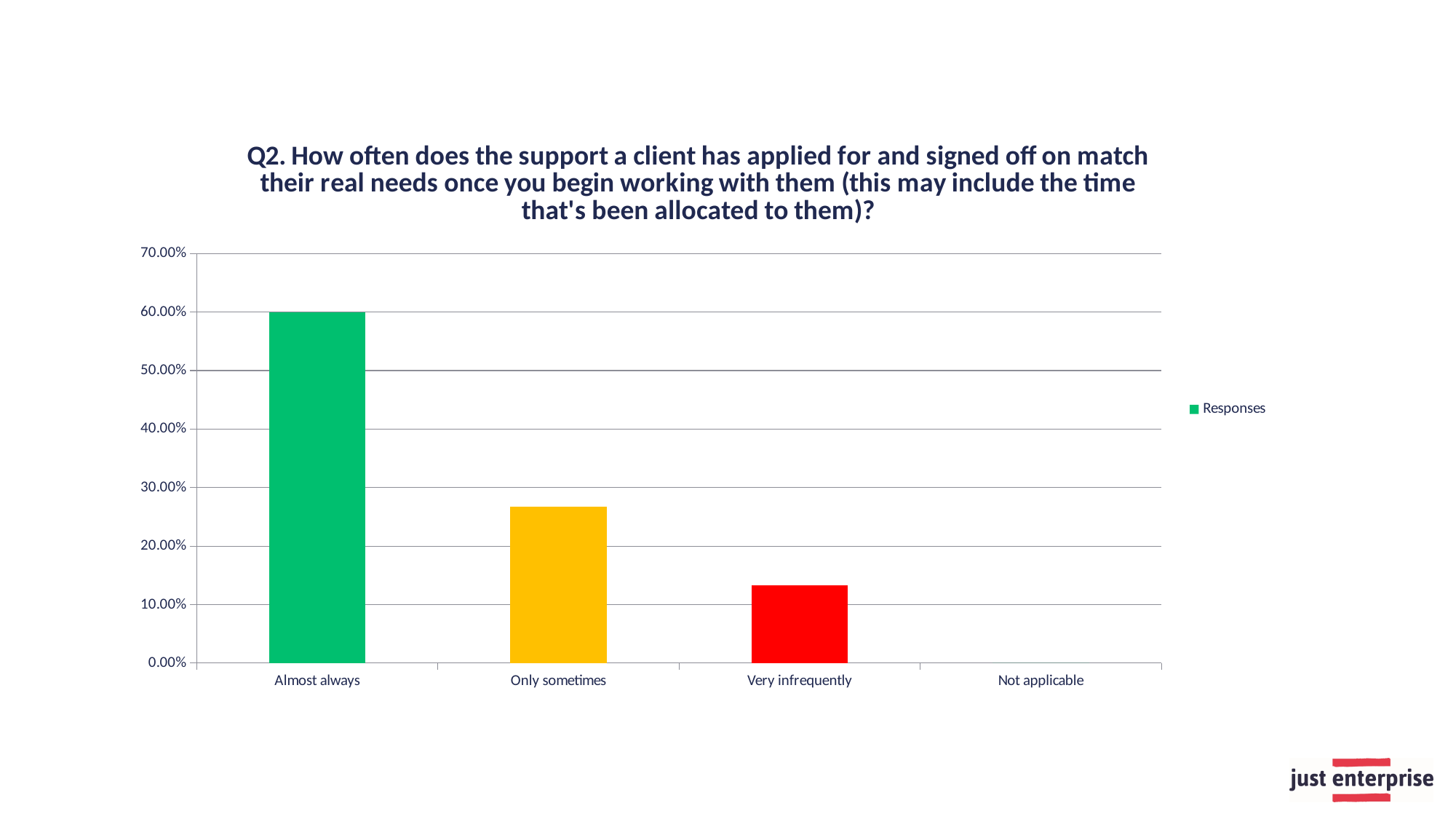
What is the value for Almost always? 60.00% Which category has the lowest value? Not applicable Which is larger, the value for Only sometimes or the value for Very infrequently? Only sometimes How many series does the legend list? 1 Is the value for Only sometimes greater or less than 30.00%? less Is the value for Very infrequently greater or less than 10.00%? greater What is the name of the series listed in the legend? Responses How many categories are shown on the x axis? 4 Do the values rise or fall from left to right along the x axis? fall Which category has the highest value? Almost always What kind of chart is shown on the slide? bar chart Is the value for Only sometimes greater or less than 20.00%? greater